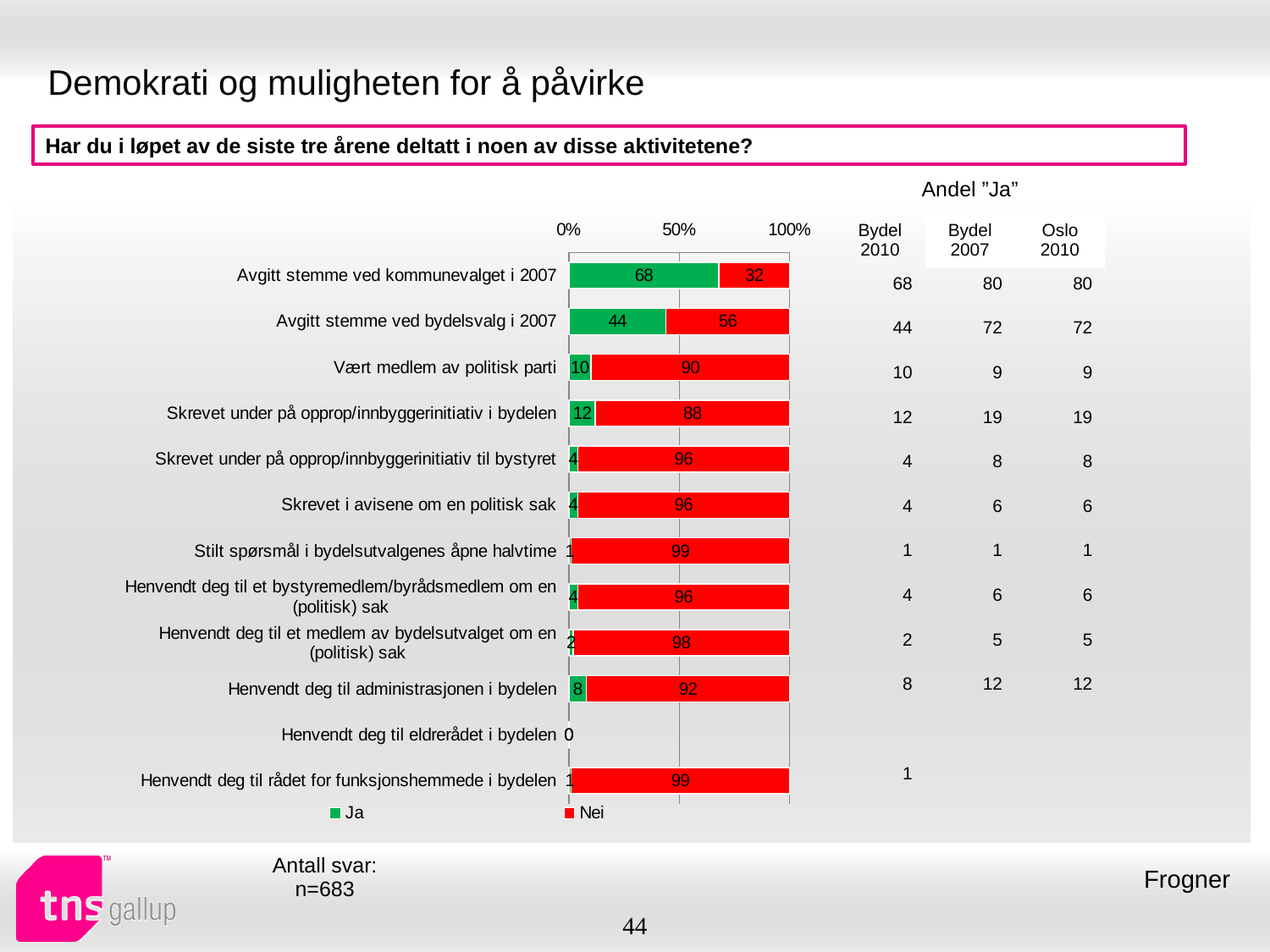
Which has a larger 'Ja' value: 'Vært medlem av politisk parti' or 'Skrevet under på opprop/innbyggerinitiativ i bydelen'? Skrevet under på opprop/innbyggerinitiativ i bydelen What kind of chart is shown on the slide? Stacked bar chart Which activity has the lowest 'Ja' value? Henvendt deg til eldrerådet i bydelen What is the 'Nei' value for 'Avgitt stemme ved bydelsvalg i 2007'? 56 What is the total of the stacked bar for 'Avgitt stemme ved kommunevalget i 2007'? 100 What is the 'Nei' value for 'Henvendt deg til administrasjonen i bydelen'? 92 Is the 'Nei' value for 'Vært medlem av politisk parti' greater or less than 50%? greater What is the difference between the 'Ja' values for 'Avgitt stemme ved kommunevalget i 2007' and 'Avgitt stemme ved bydelsvalg i 2007'? 24 How many series does the legend list? 2 Which activity has the highest 'Ja' value? Avgitt stemme ved kommunevalget i 2007 How many activities (categories) are shown in the chart? 12 What is the 'Ja' value for 'Avgitt stemme ved kommunevalget i 2007'? 68